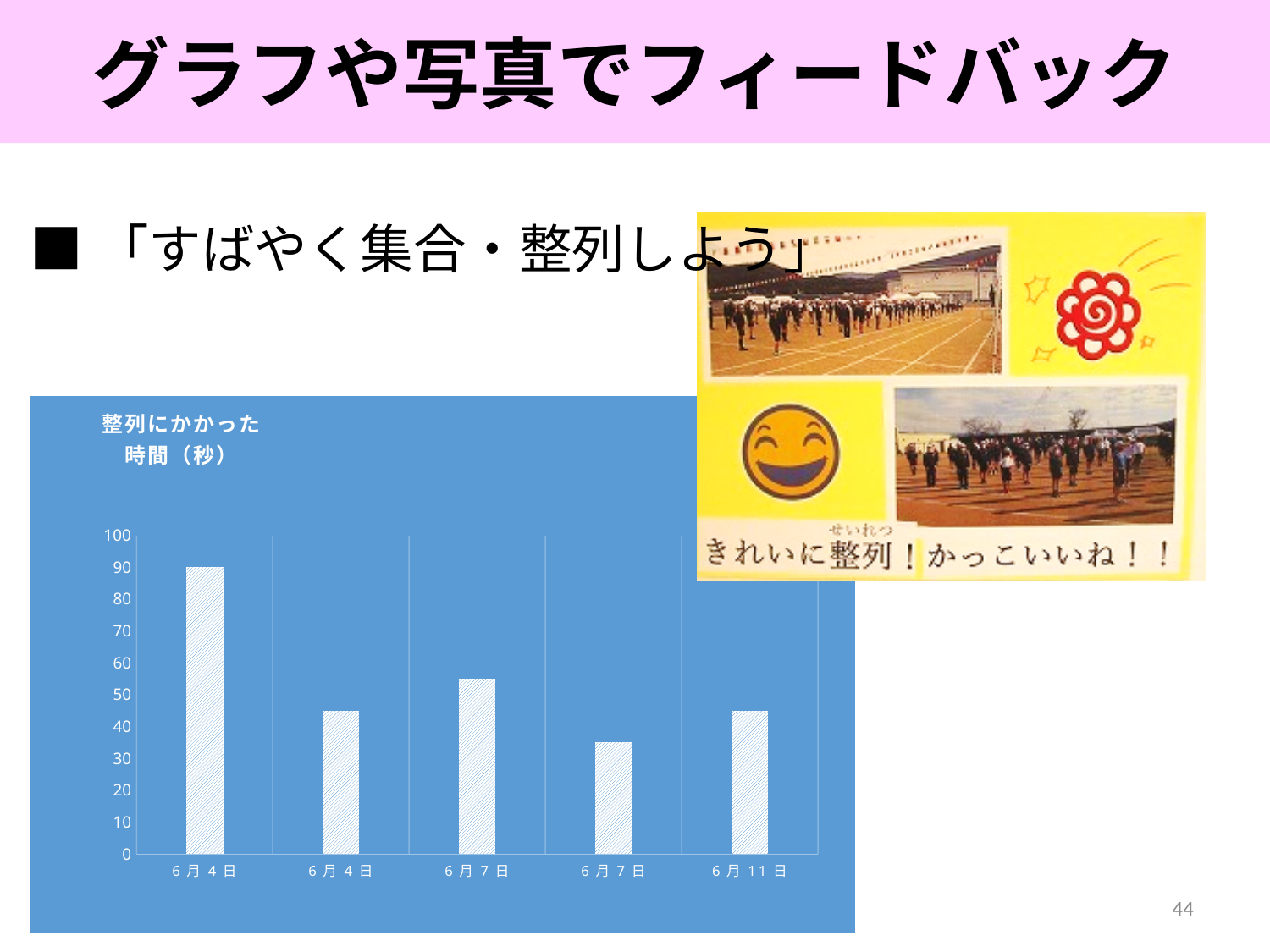
Which is larger: the first bar (6月4日) or the last bar (6月11日)? the first bar (6月4日) What is the highest tick value shown on the chart's vertical axis? 100 Is the value of the fourth bar (the second 6月7日) greater or less than 40? less What kind of chart is shown on the slide? bar chart Which bar is the lowest in the chart? the fourth bar (6月7日) Is the value of the third bar (the first 6月7日) greater or less than 50? greater How many bars are plotted in the chart? 5 Is the value of the second bar (the second 6月4日) greater or less than 50? less Which bar is the highest in the chart? the first bar (6月4日) What is the value of the first bar (the first 6月4日) in the chart? 90 What is the title of the chart? 整列にかかった時間（秒）